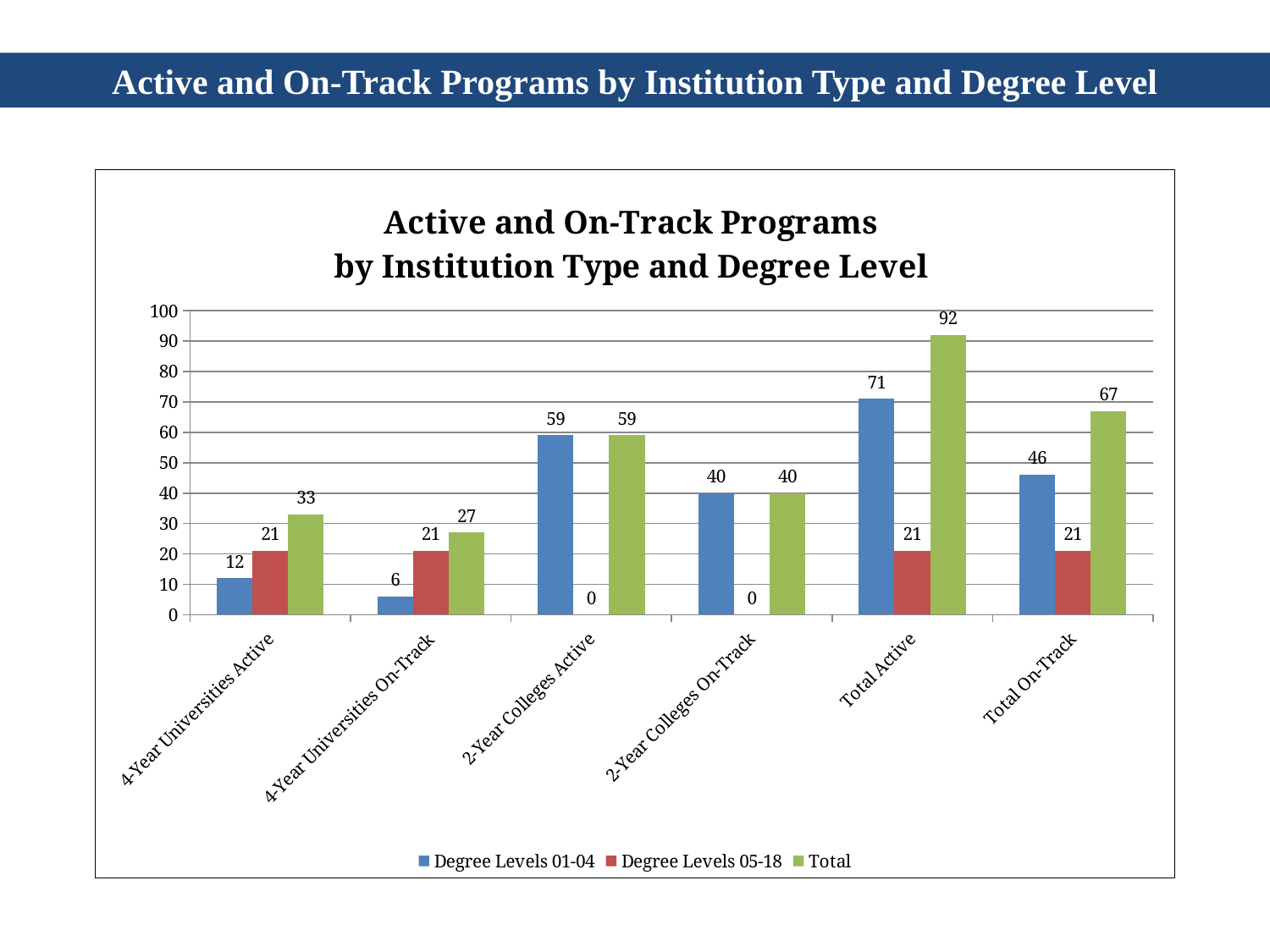
Which is larger: the Degree Levels 01-04 value for 2-Year Colleges Active or for 2-Year Colleges On-Track? 2-Year Colleges Active What is the difference between the Degree Levels 01-04 values for Total Active and 4-Year Universities Active? 59 What is the difference between the Total values for Total Active and Total On-Track? 25 What is the value for Degree Levels 01-04 in the Total On-Track category? 46 What is the Total value for Total Active? 92 Which category has the lowest Degree Levels 01-04 value? 4-Year Universities On-Track What is the value for Degree Levels 05-18 in the 2-Year Colleges Active category? 0 How many categories are shown on the x axis? 6 What kind of chart is shown on the slide? Bar chart What is the value for Degree Levels 01-04 in the 4-Year Universities Active category? 12 Which category has the highest Total value? Total Active How many series does the legend list? 3